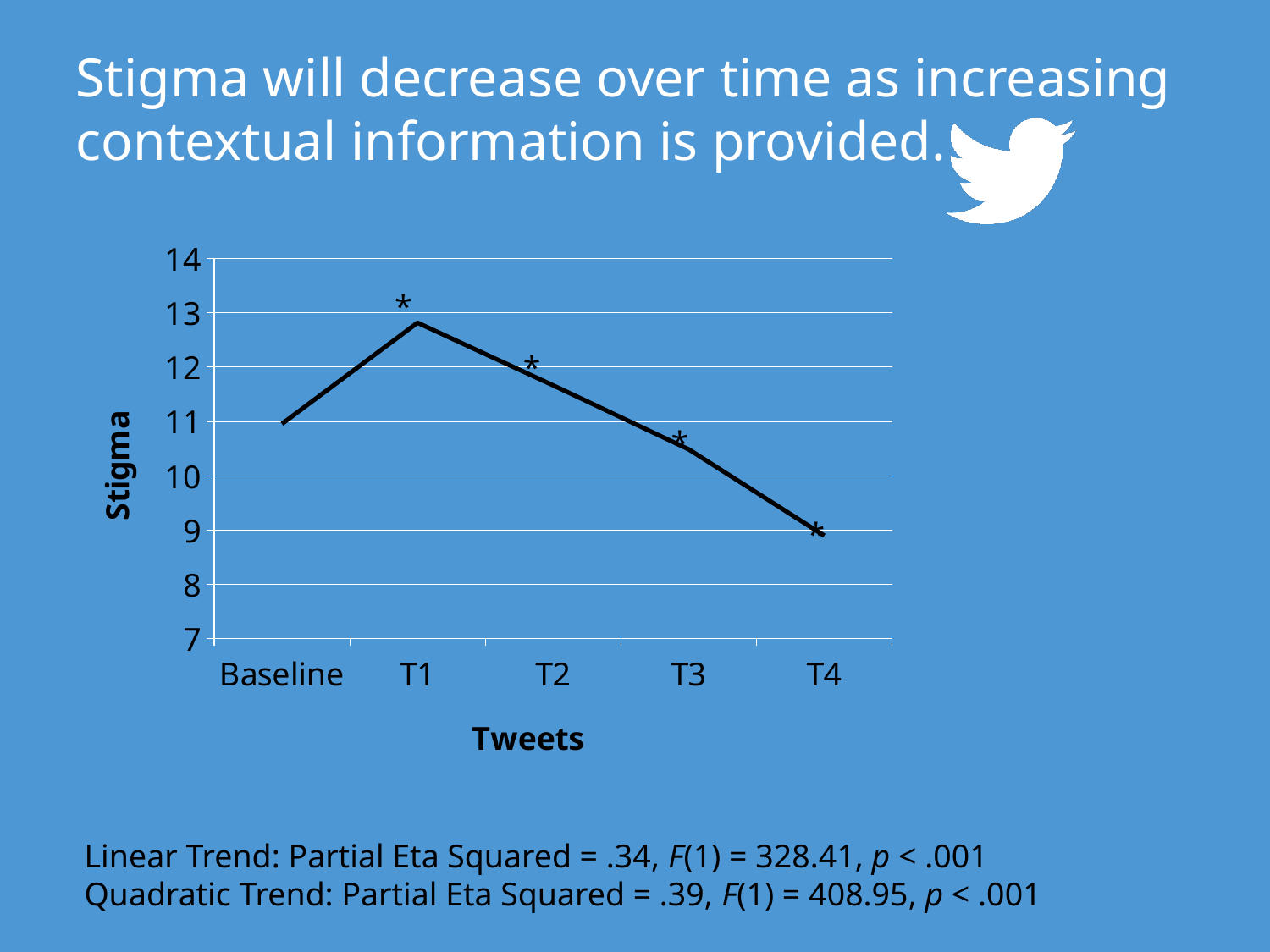
Which point on the x axis has the lowest Stigma value? T4 Which point on the x axis has the highest Stigma value? T1 Is the Stigma value at Baseline greater or less than 12? less What is the label on the x axis of the chart? Tweets What kind of chart is shown on the slide? line chart How many points are plotted along the x axis of the chart? 5 Do the Stigma values rise or fall from T1 to T4? fall Which has the larger Stigma value, T2 or T3? T2 Which has the larger Stigma value, Baseline or T1? T1 Is the Stigma value at T4 greater or less than 10? less Is the Stigma value at T1 greater or less than 12? greater